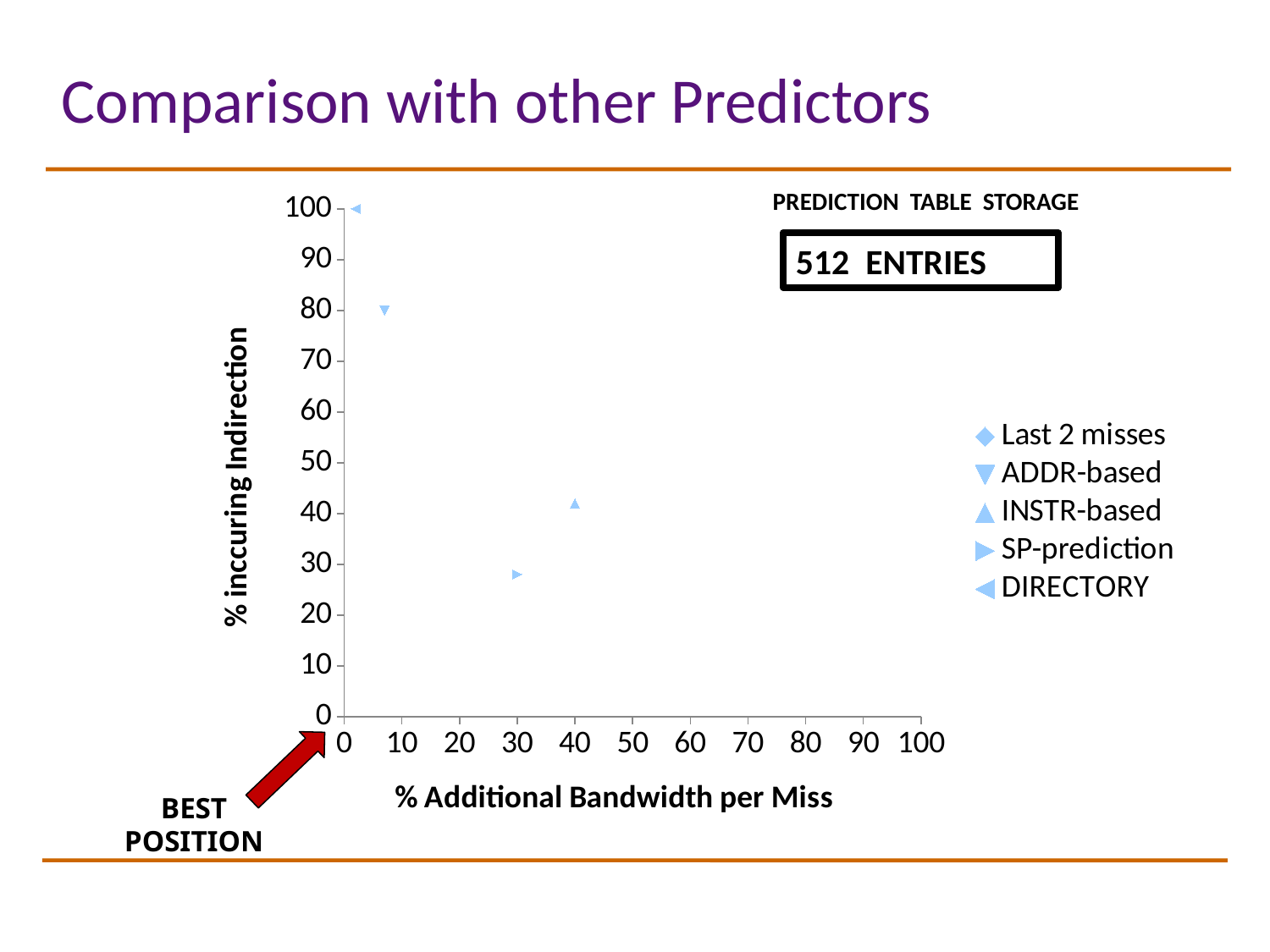
Is the % incurring indirection for SP-prediction greater or less than 20? greater How many series does the legend list? 5 Which has a higher % additional bandwidth per miss, INSTR-based or SP-prediction? INSTR-based Is the % incurring indirection for INSTR-based greater or less than 50? less Is the % additional bandwidth per miss for ADDR-based greater or less than 10? less What is the title of the x axis? % Additional Bandwidth per Miss What kind of chart is shown on the slide? scatter chart Which plotted series has the highest % incurring indirection? DIRECTORY Which plotted series has the lowest % incurring indirection? SP-prediction What is the % incurring indirection for DIRECTORY? 100 What is the title of the y axis? % inccuring Indirection